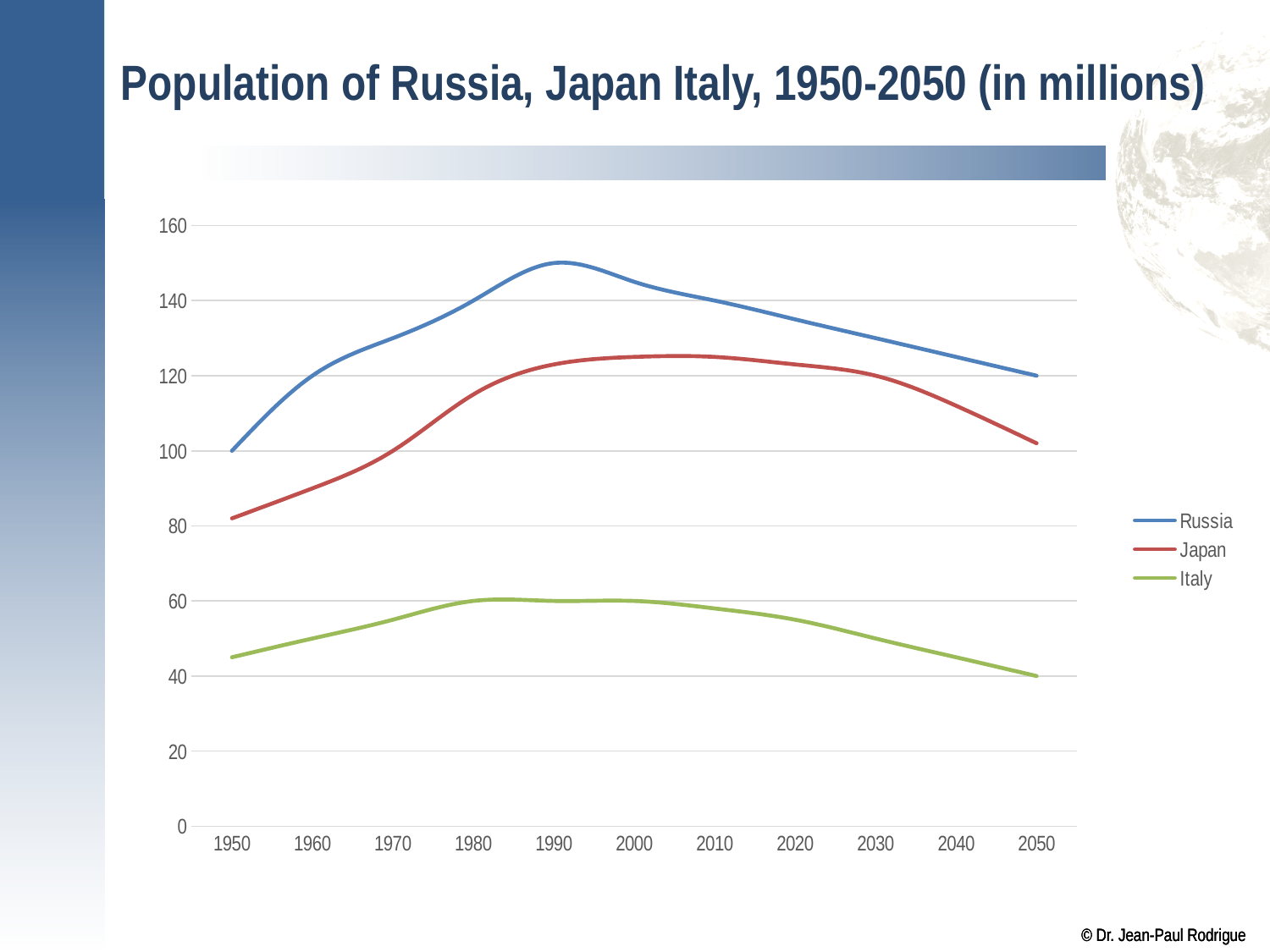
Is the value for Japan in 1950 greater or less than 100? less What is the value for Russia in 2050? 120 Which is larger in 2000, the value for Japan or the value for Italy? Japan Which series has the highest value in 1950? Russia What is the difference between Russia's value in 2050 and its value in 1950? 20 How many series does the legend list? 3 What is the value for Russia in 1950? 100 What is the value for Italy in 2050? 40 How many years are marked along the x axis? 11 Does the value for Russia rise or fall from 1990 to 2050? fall Is the value for Russia in 1990 greater or less than 140? greater What kind of chart is shown on the slide? line chart